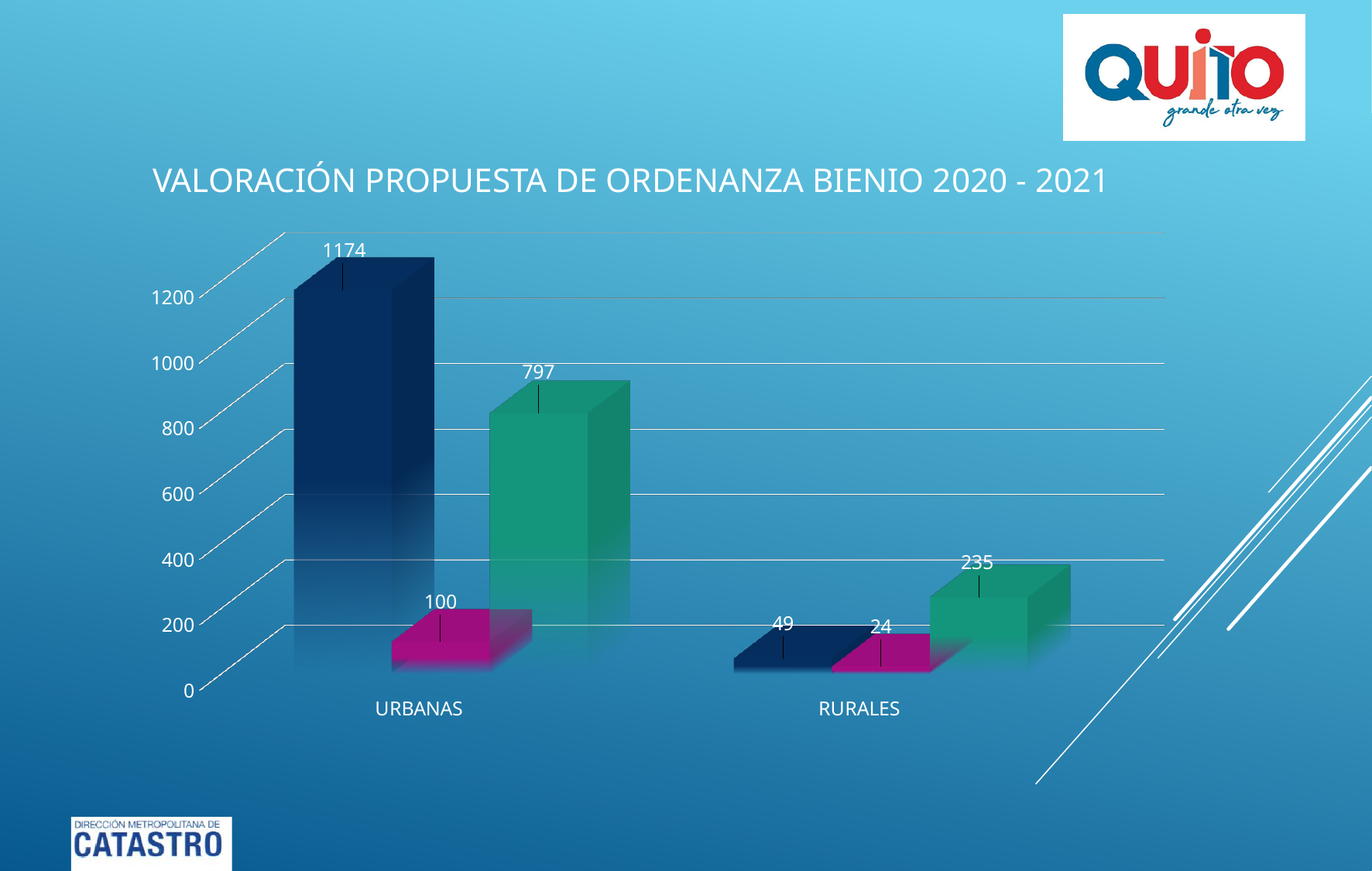
What is the difference between the dark blue bar and the green bar for URBANAS? 377 Which bar has the highest value in the chart? The dark blue bar for URBANAS (1174) Which is larger: the green bar for RURALES or the magenta bar for URBANAS? The green bar for RURALES What is the value of the dark blue bar for URBANAS? 1174 What is the value of the green bar for RURALES? 235 What is the value of the green bar for URBANAS? 797 What is the value of the dark blue bar for RURALES? 49 What is the title of the chart? VALORACIÓN PROPUESTA DE ORDENANZA BIENIO 2020 - 2021 What is the value of the magenta bar for URBANAS? 100 What is the value of the magenta bar for RURALES? 24 How many categories are shown on the x axis? 2 Which bar has the lowest value in the chart? The magenta bar for RURALES (24)